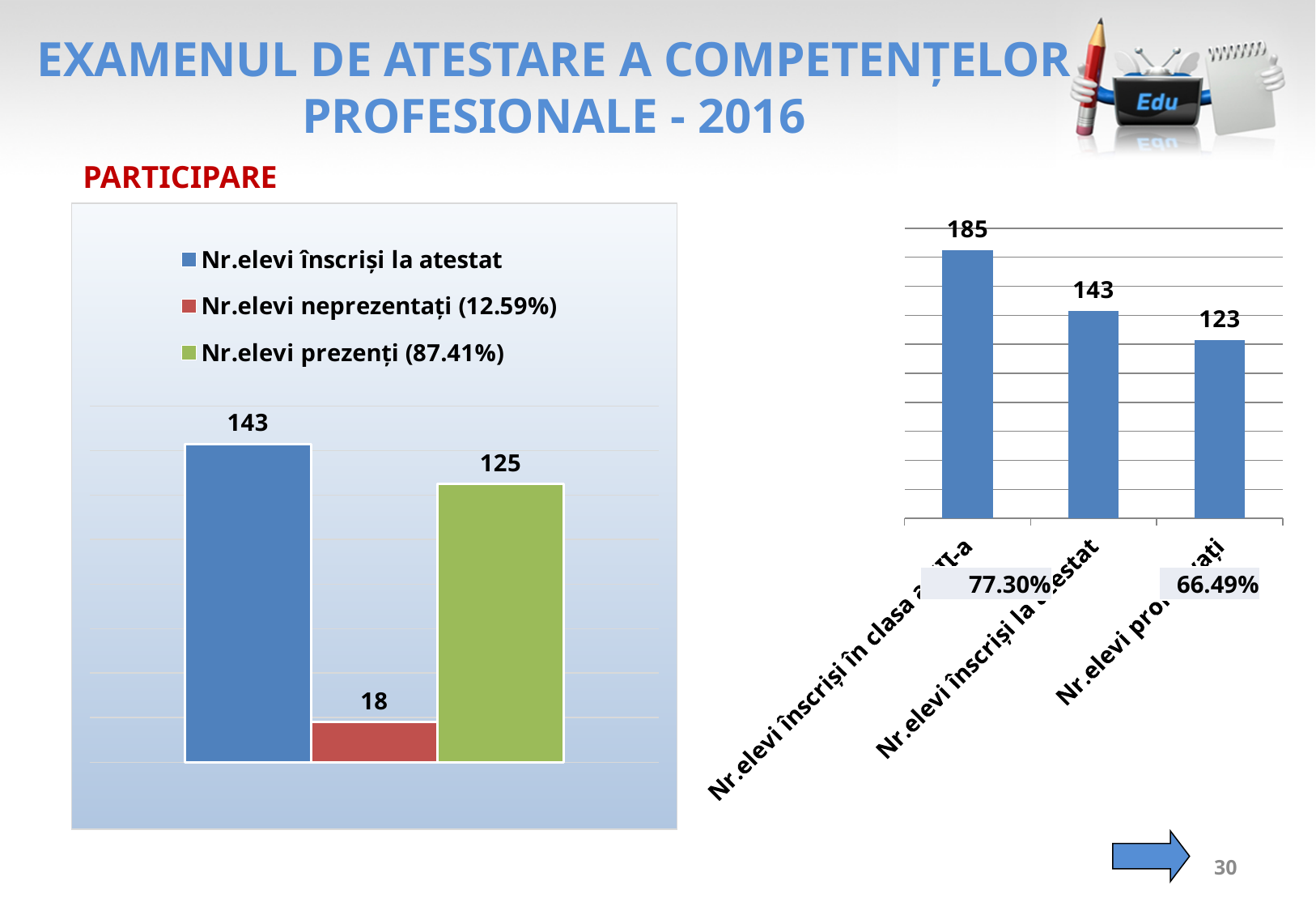
On the left chart, which series has the highest value? Nr.elevi înscriși la atestat On the left chart, what is the difference between Nr.elevi înscriși la atestat and Nr.elevi prezenți (87.41%)? 18 On the right chart, what is the value of the first (leftmost) bar? 185 What kind of chart is the left chart? bar chart On the left chart, what is the value for Nr.elevi prezenți (87.41%)? 125 On the right chart, do the values rise or fall from left to right? fall On the left chart, what is the value for Nr.elevi neprezentați (12.59%)? 18 How many series does the legend of the left chart list? 3 On the left chart, what is the value for Nr.elevi înscriși la atestat? 143 On the right chart, what is the value for Nr.elevi înscriși la atestat? 143 On the right chart, what is the value of the third (rightmost) bar? 123 On the left chart, which series has the lowest value? Nr.elevi neprezentați (12.59%)